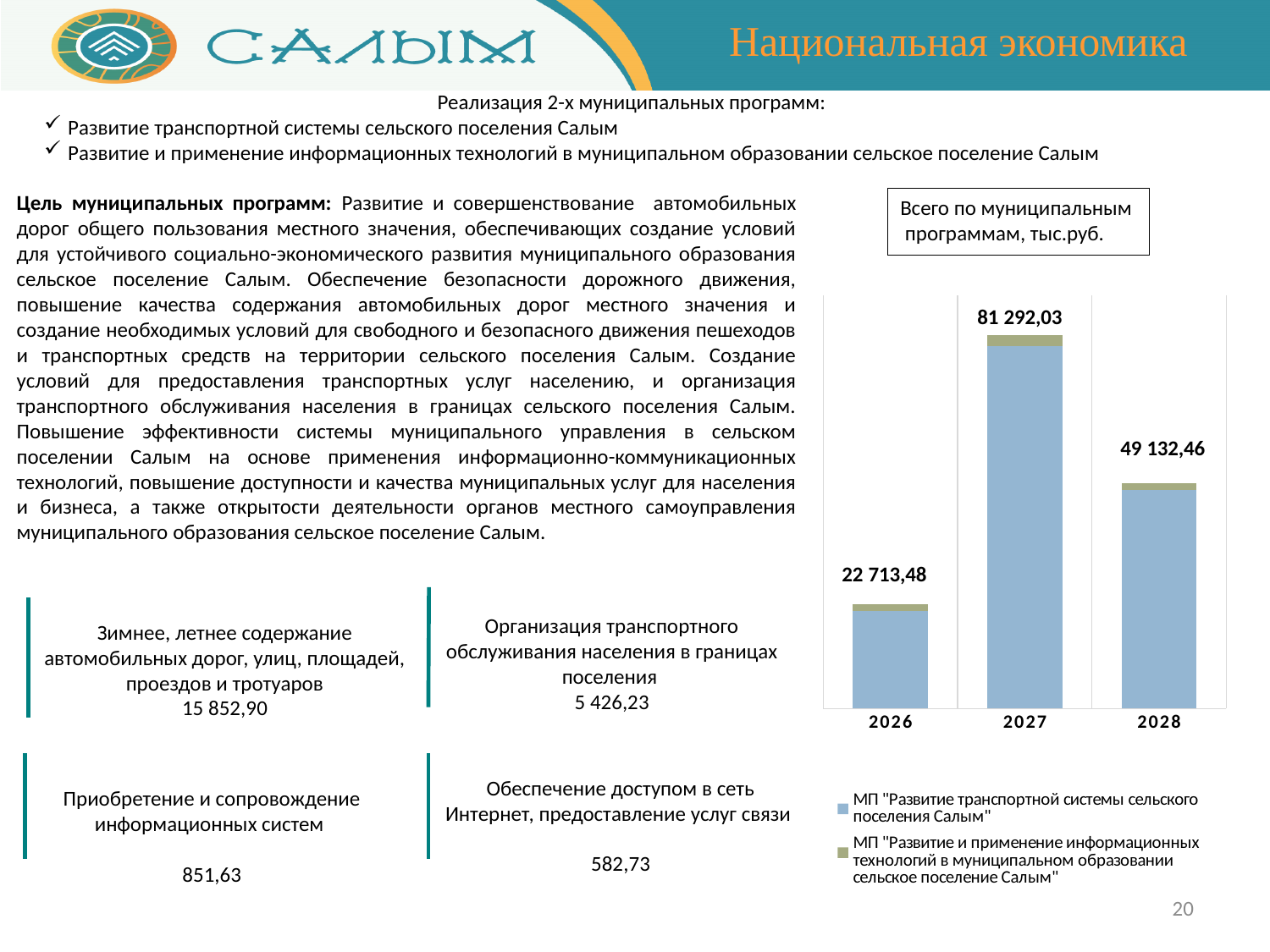
Which year has the lowest total value? 2026 How many series does the chart legend list? 2 What is the difference between the total for 2027 and the total for 2028? 32 159,57 What is the difference between the total for 2027 and the total for 2026? 58 578,55 Which year has a larger total, 2028 or 2026? 2028 What is the total value shown for 2027? 81 292,03 Which year has the highest total value? 2027 What is the total value shown for 2028? 49 132,46 What is the total value shown for 2026? 22 713,48 What is the title of the chart? Всего по муниципальным программам, тыс.руб. What kind of chart is shown on the slide? Stacked bar chart How many years are shown on the x axis of the chart? 3